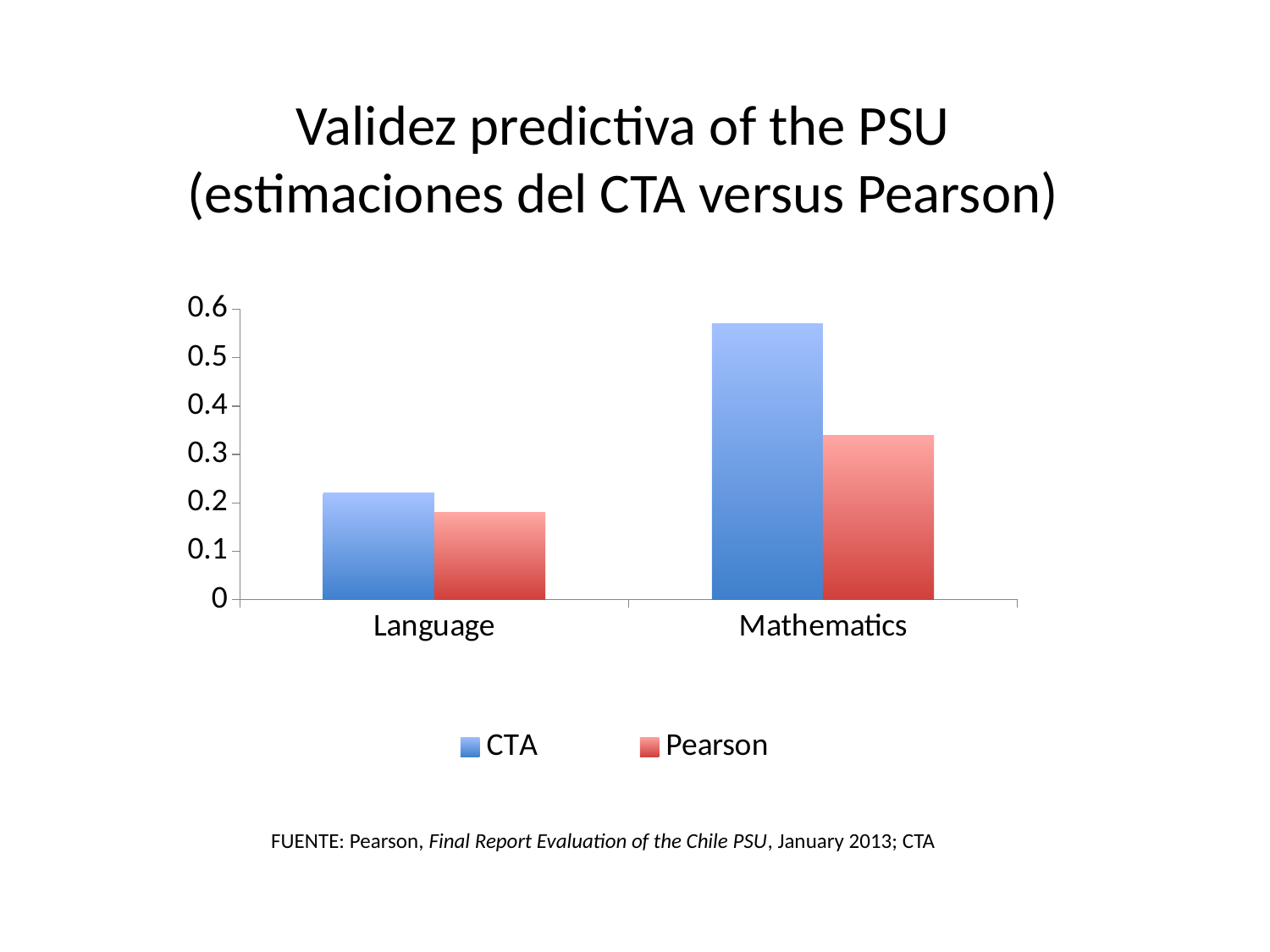
Is the CTA value for Mathematics greater or less than 0.5? greater Is the Pearson value for Mathematics greater or less than 0.4? less What kind of chart is shown on the slide? bar chart How many series does the legend list? 2 Which category has the lowest Pearson value? Language For Language, which series has the larger value, CTA or Pearson? CTA Is the CTA value for Language greater or less than 0.3? less Which series is shown in red in the legend? Pearson How many categories are shown on the x axis? 2 What is the title of the chart on the slide? Validez predictiva of the PSU (estimaciones del CTA versus Pearson) For Mathematics, which series has the larger value, CTA or Pearson? CTA Which category has the highest CTA value? Mathematics